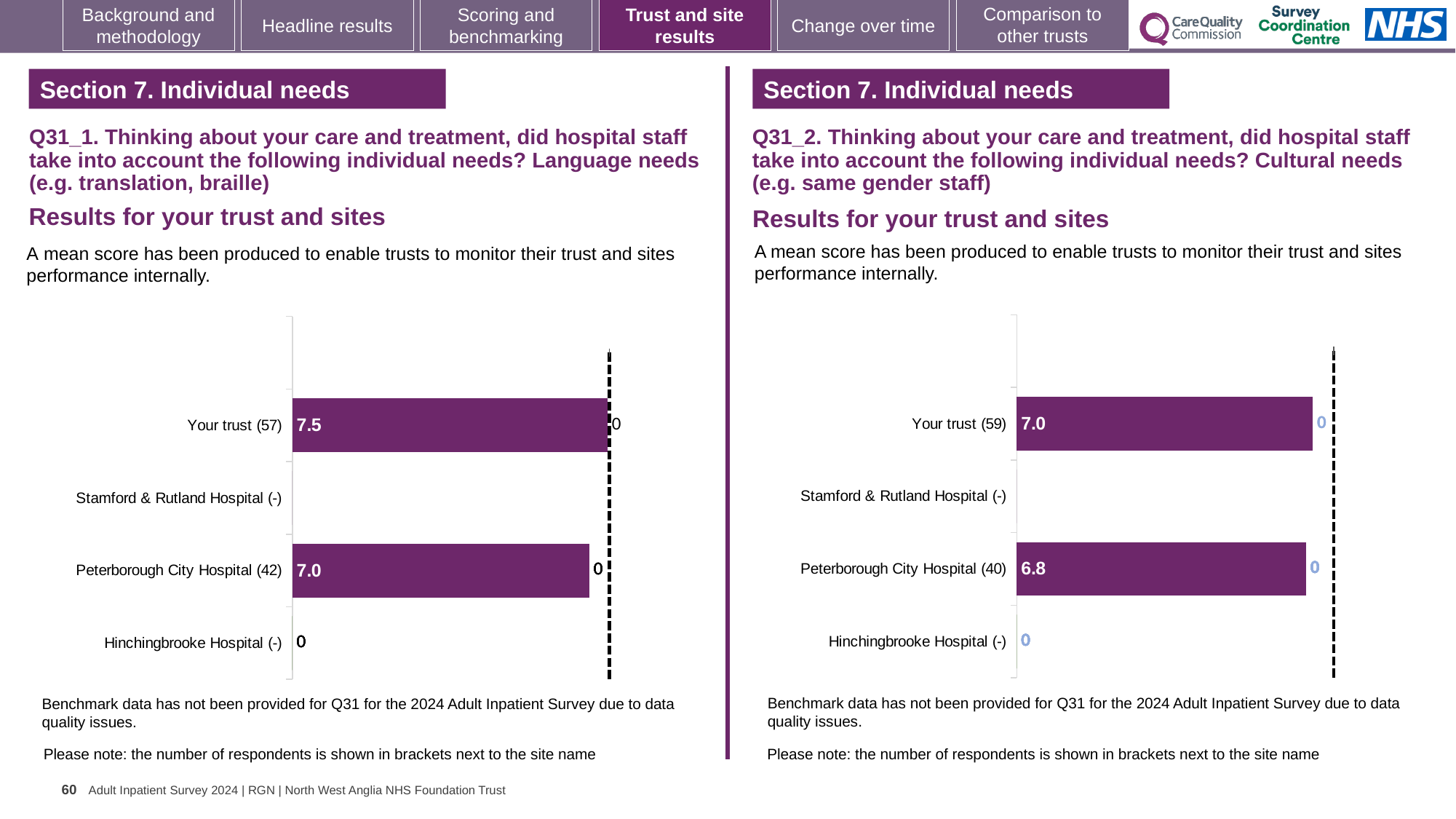
On the left chart (Q31_1, Language needs), what is the mean score for Peterborough City Hospital? 7.0 How many site/trust categories are listed on the right chart (Q31_2, Cultural needs)? 4 On the right chart (Q31_2, Cultural needs), what is the mean score for Peterborough City Hospital? 6.8 What type of chart is used on the left side of the slide (Q31_1, Language needs)? Bar chart On the left chart (Q31_1, Language needs), what is the mean score for Your trust? 7.5 On the left chart (Q31_1, Language needs), what is the difference between the mean scores for Your trust and Peterborough City Hospital? 0.5 On the right chart (Q31_2, Cultural needs), what is the mean score for Your trust? 7.0 On the left chart (Q31_1, Language needs), which has the higher mean score: Your trust or Peterborough City Hospital? Your trust On the right chart (Q31_2, Cultural needs), what is the difference between the mean scores for Your trust and Peterborough City Hospital? 0.2 On the left chart (Q31_1, Language needs), how many respondents are shown in brackets for Your trust? 57 On the right chart (Q31_2, Cultural needs), how many respondents are shown in brackets for Peterborough City Hospital? 40 On the right chart (Q31_2, Cultural needs), which has the higher mean score: Your trust or Peterborough City Hospital? Your trust